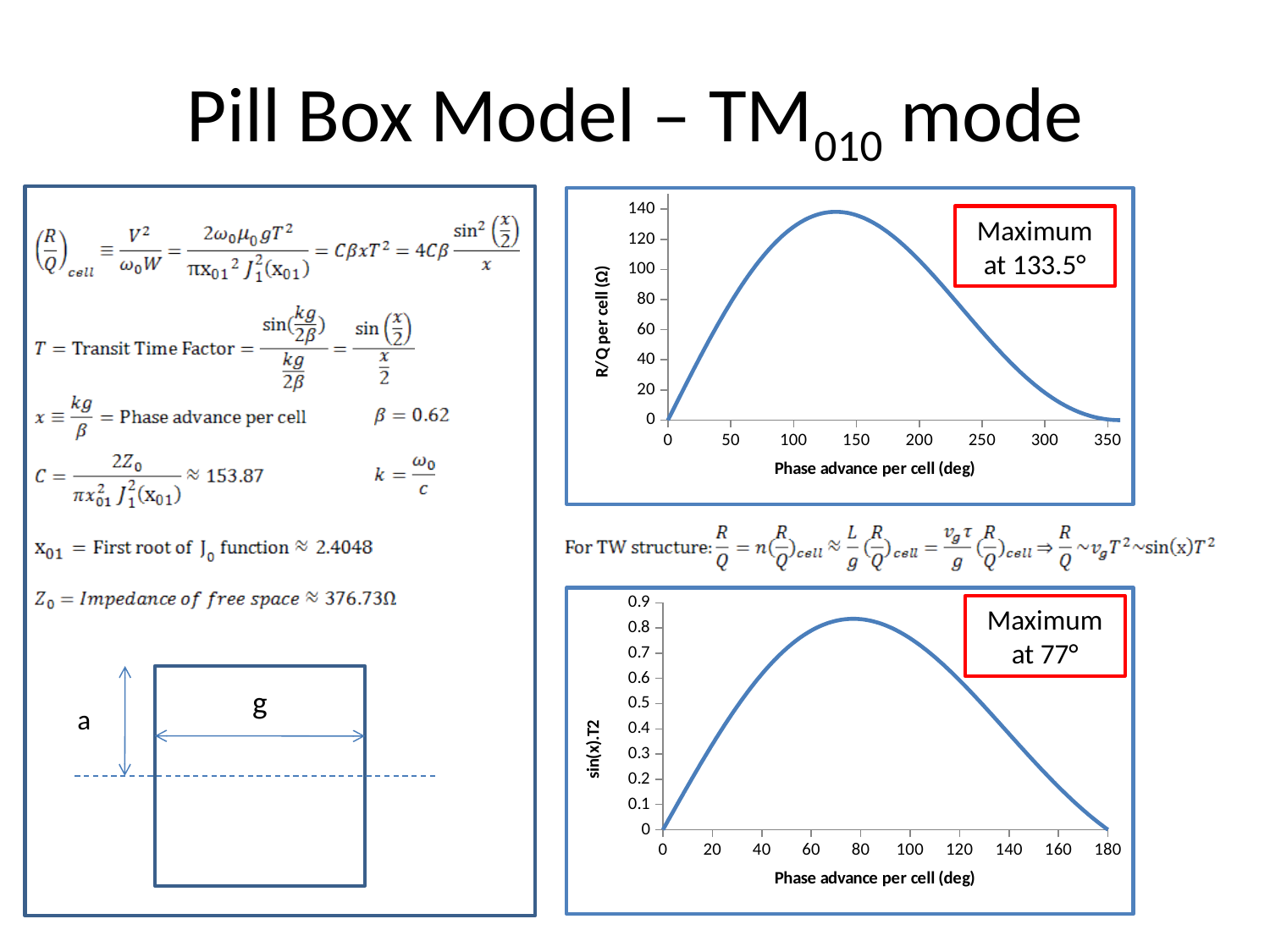
In the bottom chart (sin(x).T2), does the curve rise or fall as the phase advance increases from 0 deg to 60 deg? rise In the bottom chart (sin(x).T2), is the value at a phase advance of 80 deg greater or less than 0.7? greater In the top chart (R/Q per cell), is the value at a phase advance of 300 deg greater or less than 40? less In the top chart (R/Q per cell), at what phase advance per cell does the curve reach its maximum, according to the annotation? 133.5° What is the y-axis label of the top chart on the right? R/Q per cell (Ω) In the bottom chart (sin(x).T2), at what phase advance per cell does the curve reach its maximum, according to the annotation? 77° In the top chart (R/Q per cell), does the curve rise or fall as the phase advance increases from 150 deg to 300 deg? fall In the bottom chart (sin(x).T2), is the value at a phase advance of 160 deg greater or less than 0.4? less What kind of chart is the top chart on the right (R/Q per cell vs phase advance)? line chart What kind of chart is the bottom chart on the right (sin(x).T2 vs phase advance)? line chart